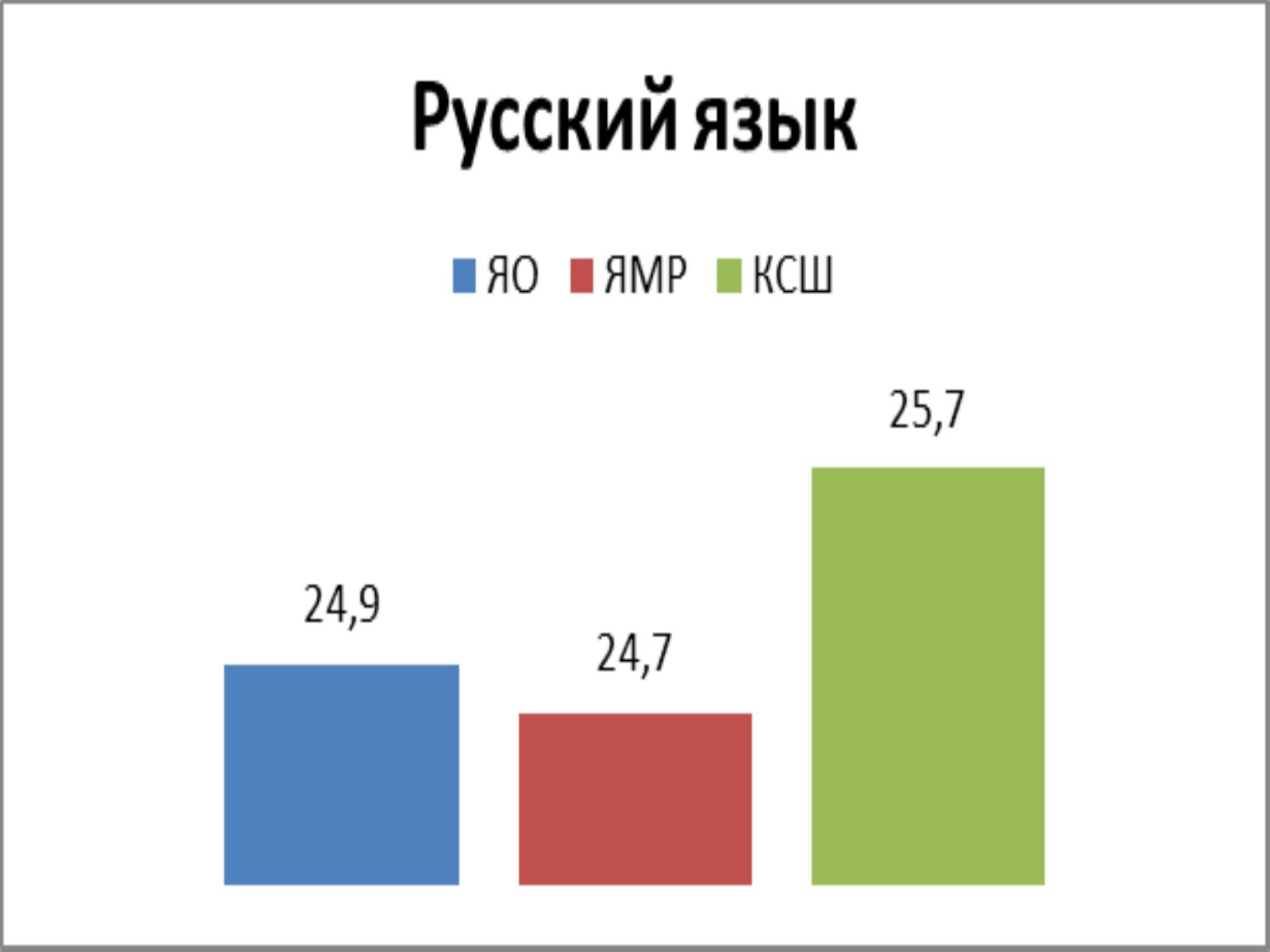
How many bars are plotted on the chart? 3 What is the difference between the values for ЯО and ЯМР? 0,2 Which series has the lowest value? ЯМР What is the value for ЯМР? 24,7 Which is larger, the value for КСШ or the value for ЯМР? КСШ What is the value for КСШ? 25,7 What kind of chart is shown? bar chart What is the title of the chart? Русский язык What is the value for ЯО? 24,9 Which series has the highest value? КСШ How many series does the legend list? 3 What is the difference between the values for КСШ and ЯО? 0,8